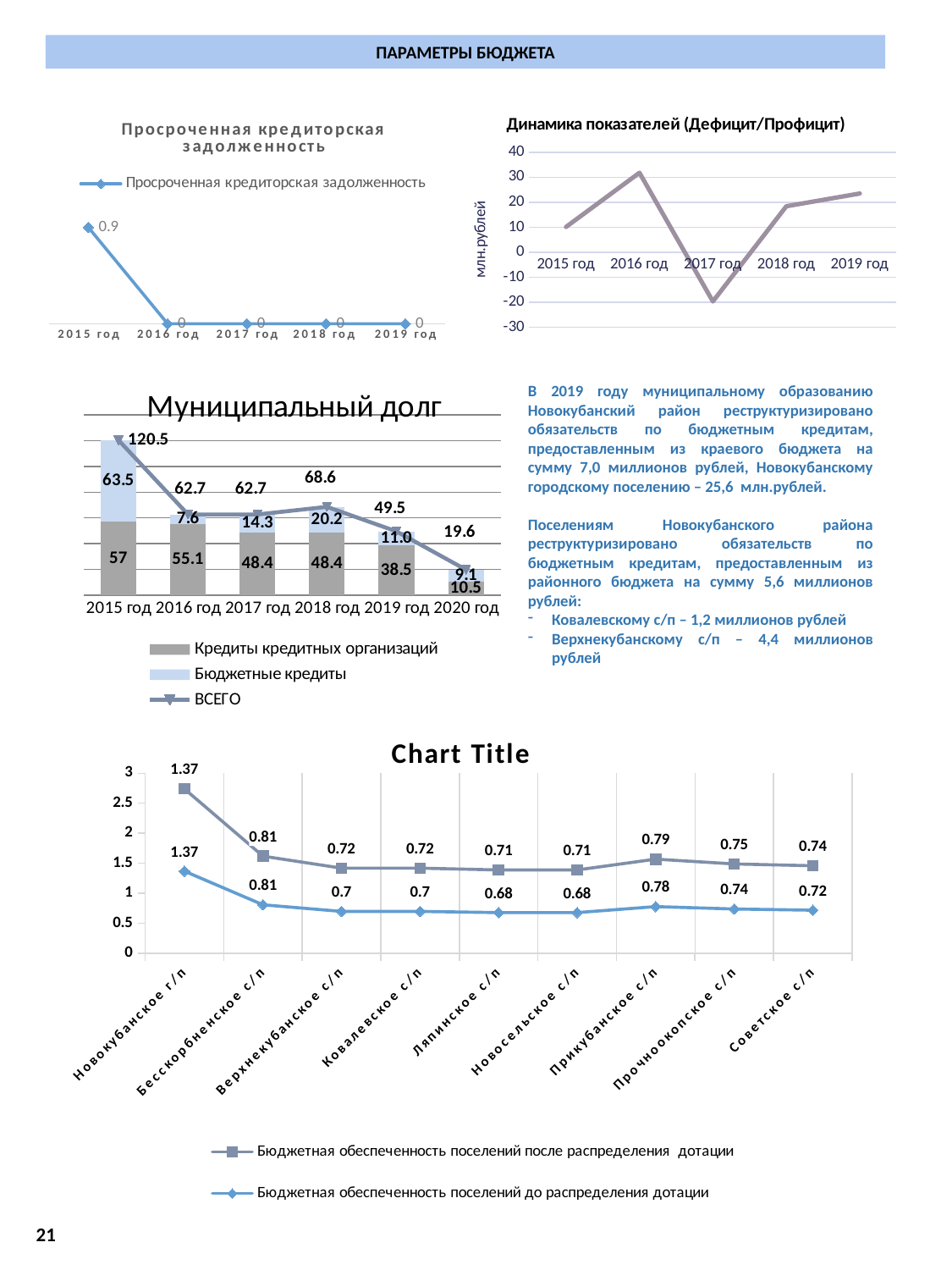
In the 'Просроченная кредиторская задолженность' chart, what is the value for 2018 год? 0 In the 'Динамика показателей (Дефицит/Профицит)' chart, which year has the lowest value? 2017 год In the 'Просроченная кредиторская задолженность' chart, what is the value for 2015 год? 0.9 In the 'Chart Title' chart at the bottom, how many categories are shown on the x axis? 9 In the 'Динамика показателей (Дефицит/Профицит)' chart, is the value for 2017 год greater or less than -10? less In the 'Муниципальный долг' chart, what is the total (ВСЕГО) for 2018 год? 68.6 In the 'Динамика показателей (Дефицит/Профицит)' chart, is the value for 2016 год greater or less than 20? greater In the 'Муниципальный долг' chart, what is the value of 'Бюджетные кредиты' for 2015 год? 63.5 In the 'Муниципальный долг' chart, what is the value of 'Кредиты кредитных организаций' for 2019 год? 38.5 In the 'Муниципальный долг' chart, what is the difference between the 'Кредиты кредитных организаций' values for 2016 год and 2020 год? 44.6 In the 'Chart Title' chart at the bottom, what is the value of 'Бюджетная обеспеченность поселений до распределения дотации' for Ляпинское с/п? 0.68 In the 'Муниципальный долг' chart, how many series does the legend list? 3